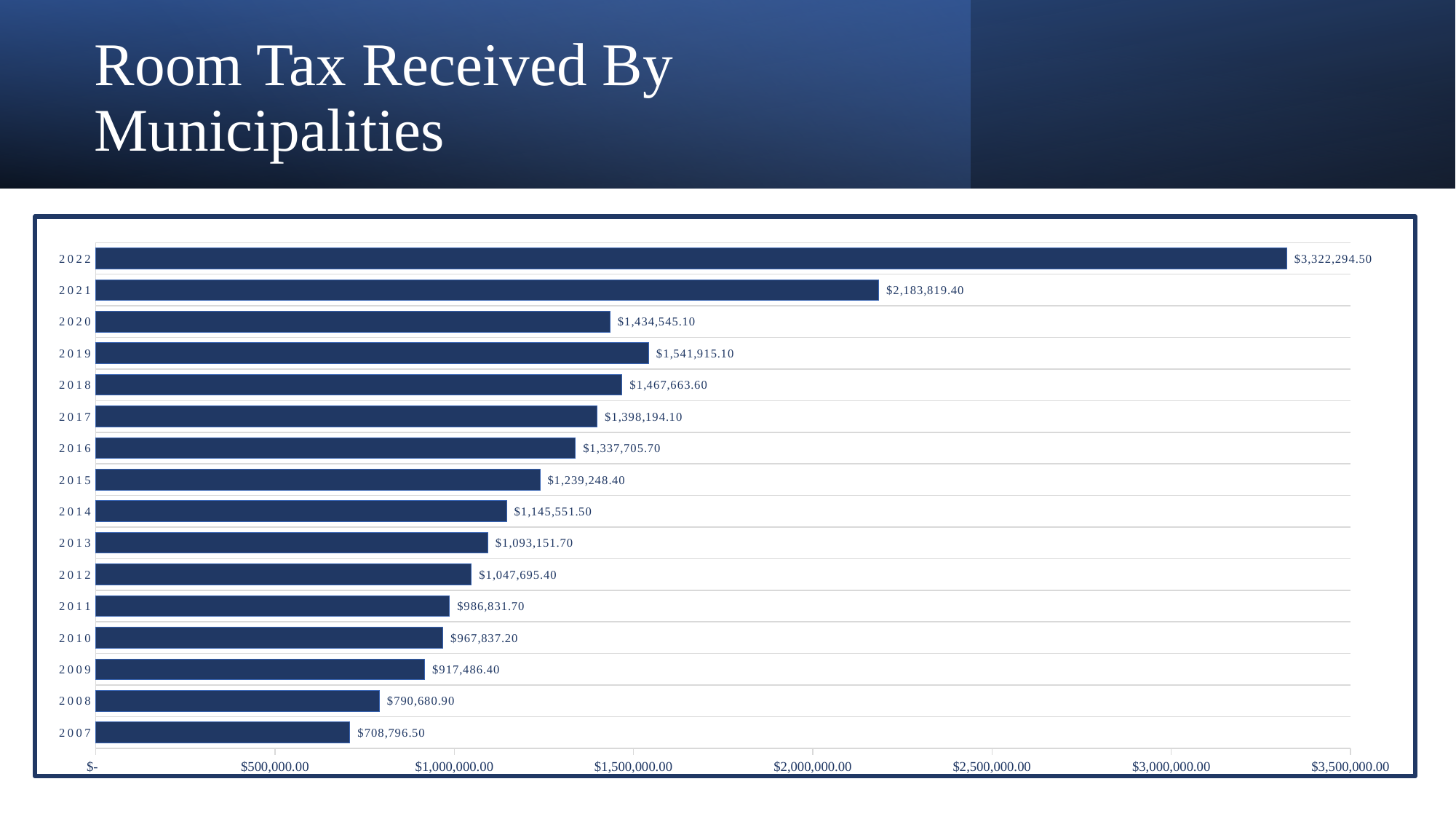
Which year had more room tax received, 2019 or 2018? 2019 Do the room tax values generally rise or fall from 2007 to 2022? Rise What is the difference between the room tax received in 2019 and in 2020? $107,370.00 What is the room tax received in 2022? $3,322,294.50 What is the room tax received in 2007? $708,796.50 What kind of chart is shown on the slide? Bar chart How many years are shown in the chart? 16 Which year has the lowest room tax received? 2007 What is the difference between the room tax received in 2022 and in 2021? $1,138,475.10 Is the value for 2021 greater or less than $2,000,000.00? greater Which year has the highest room tax received? 2022 What is the room tax received in 2015? $1,239,248.40